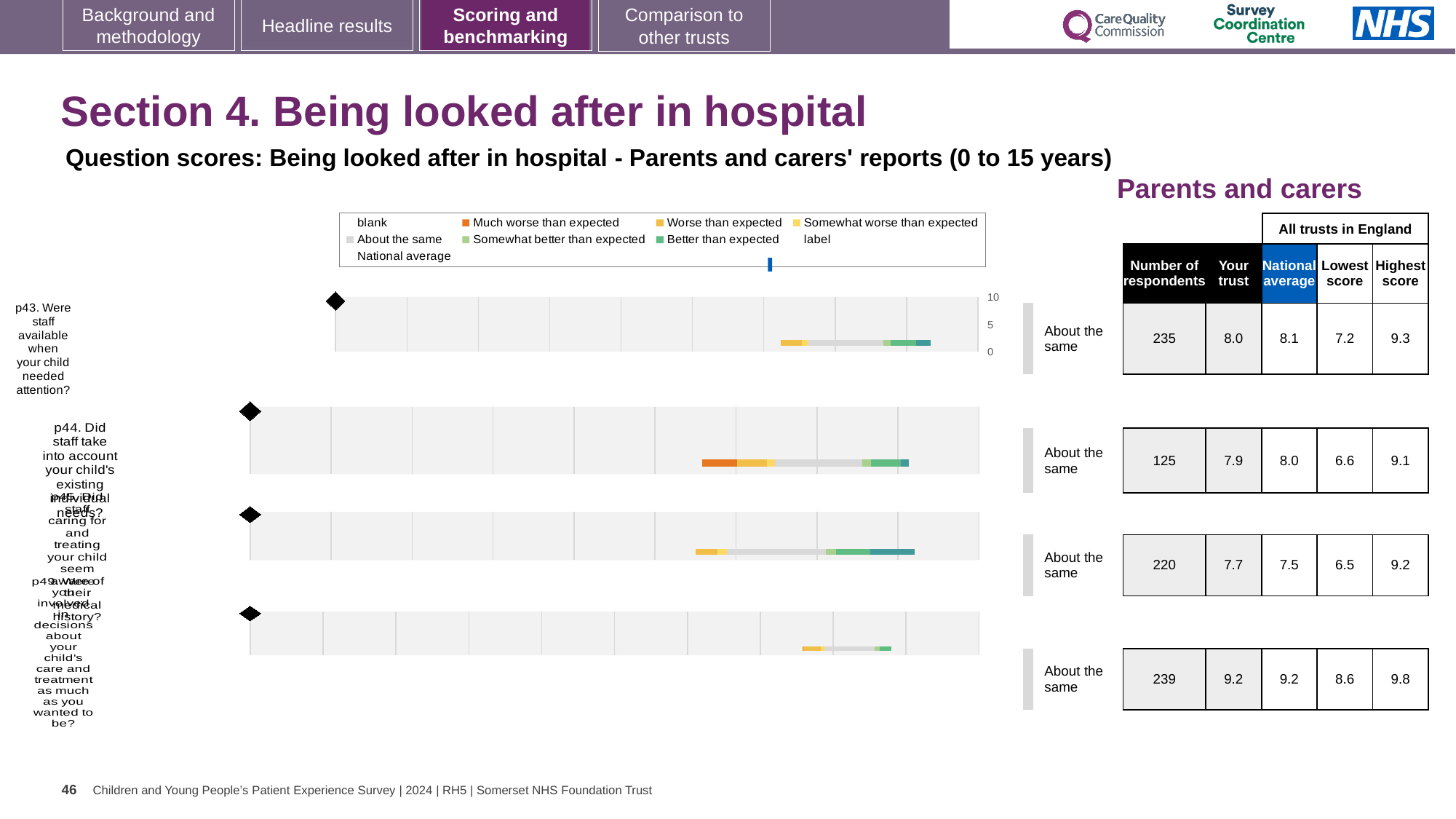
For p44 (Did staff take into account your child's existing individual needs?), which is larger: the 'Your trust' score or the national average? National average What is the national average score for p45 (Did staff caring for and treating your child seem aware of their medical history?)? 7.5 What is the 'Your trust' score for p49 (Were you involved in decisions about your child's care and treatment as much as you wanted to be?)? 9.2 Which question has the highest 'Your trust' score? p49 What kind of chart is shown on the slide? bar chart What is the difference between the highest score and the lowest score for p43 (Were staff available when your child needed attention?)? 2.1 What is the subtitle of the chart on the slide? Question scores: Being looked after in hospital - Parents and carers' reports (0 to 15 years) What is the number of respondents for p43 (Were staff available when your child needed attention?)? 235 How many questions (rows) are plotted in the chart? 4 What is the benchmark category shown for p43 (Were staff available when your child needed attention?)? About the same How many entries does the chart legend list? 9 Which question has the lowest 'Your trust' score? p45